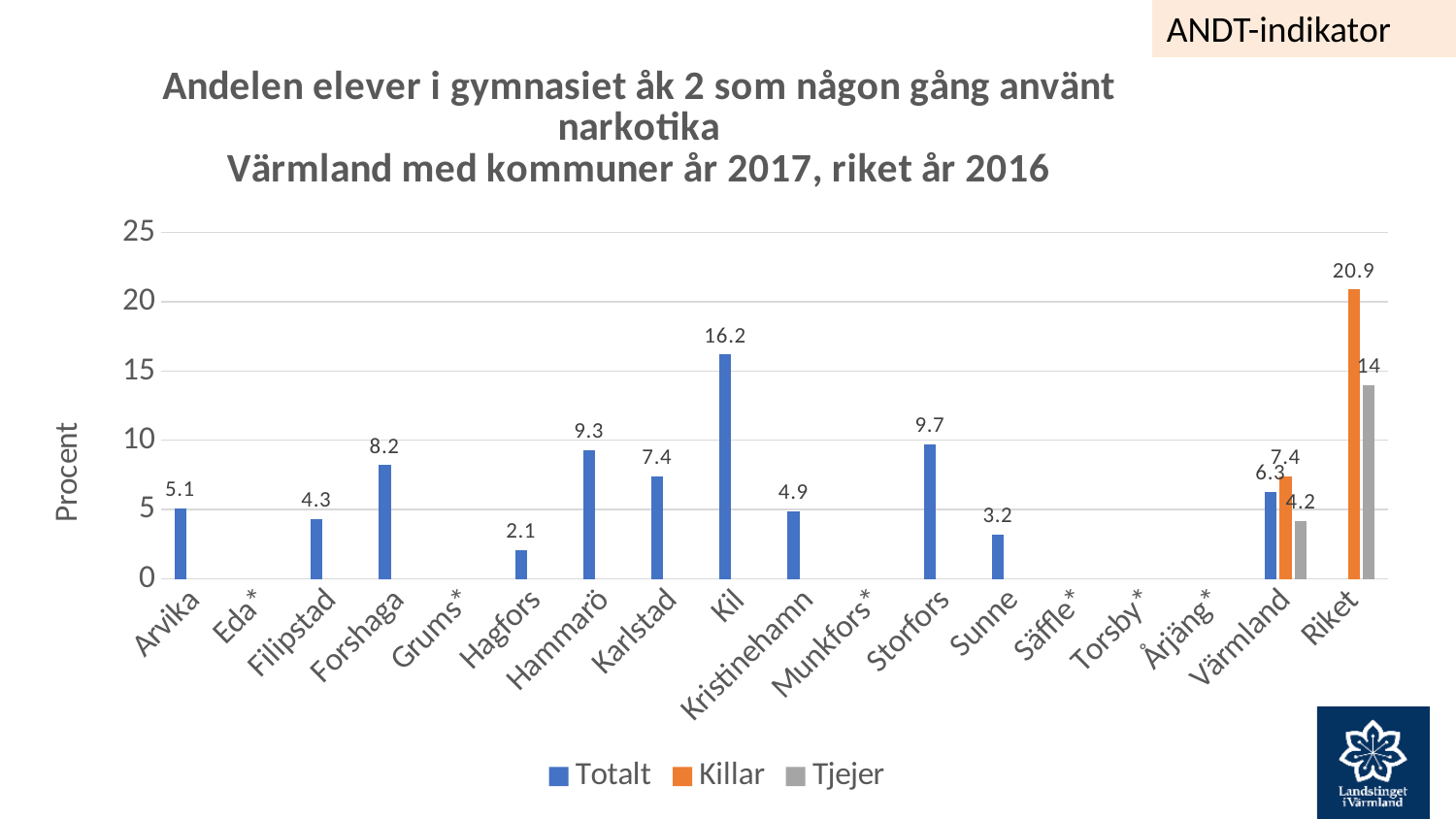
Among the municipalities with a plotted Totalt bar, which has the lowest value? Hagfors What is the Tjejer value for Värmland? 4.2 Which municipality has the highest Totalt value? Kil Which is larger, the Totalt value for Hammarö or for Storfors? Storfors What is the Totalt value for Kil? 16.2 What is the label on the y axis? Procent What kind of chart is this? Bar chart Is the Totalt value for Forshaga greater or less than 5? greater What is the Killar value for Riket? 20.9 How many categories are shown on the x axis? 18 How many series does the legend list? 3 What is the difference between the Killar and Tjejer values for Riket? 6.9